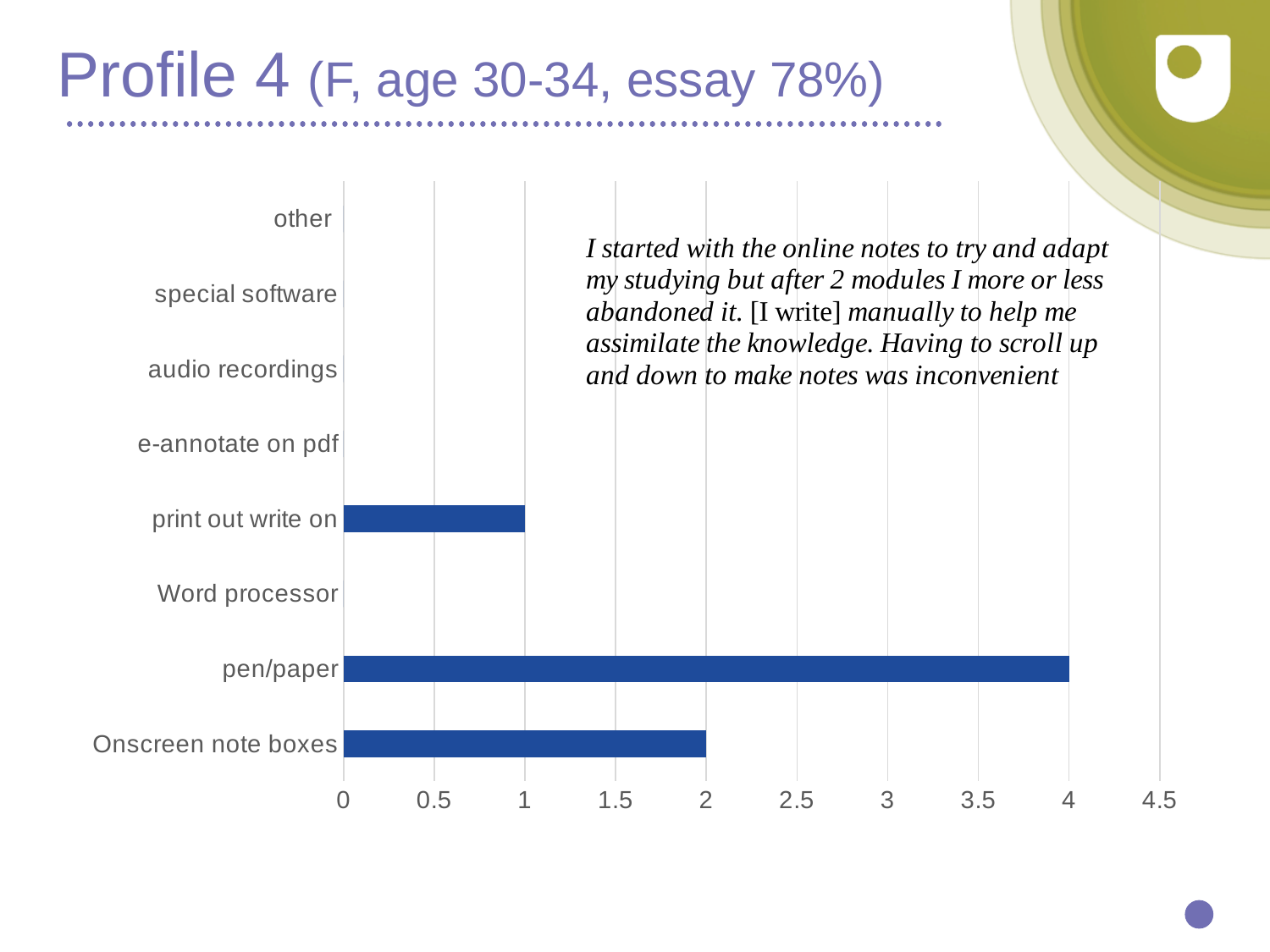
What is the value for print out write on? 1 What is the highest value shown on the horizontal axis of the chart? 4.5 Is the value for print out write on greater or less than 1.5? less What is the difference between the values for Onscreen note boxes and print out write on? 1 How many categories are listed on the vertical axis of the chart? 8 Which category has the highest value? pen/paper What is the difference between the values for pen/paper and Onscreen note boxes? 2 What is the value for pen/paper? 4 Is the value for pen/paper greater or less than 3? greater What is the value for Onscreen note boxes? 2 What kind of chart is shown on the slide? bar chart Which is larger, the value for Onscreen note boxes or the value for print out write on? Onscreen note boxes